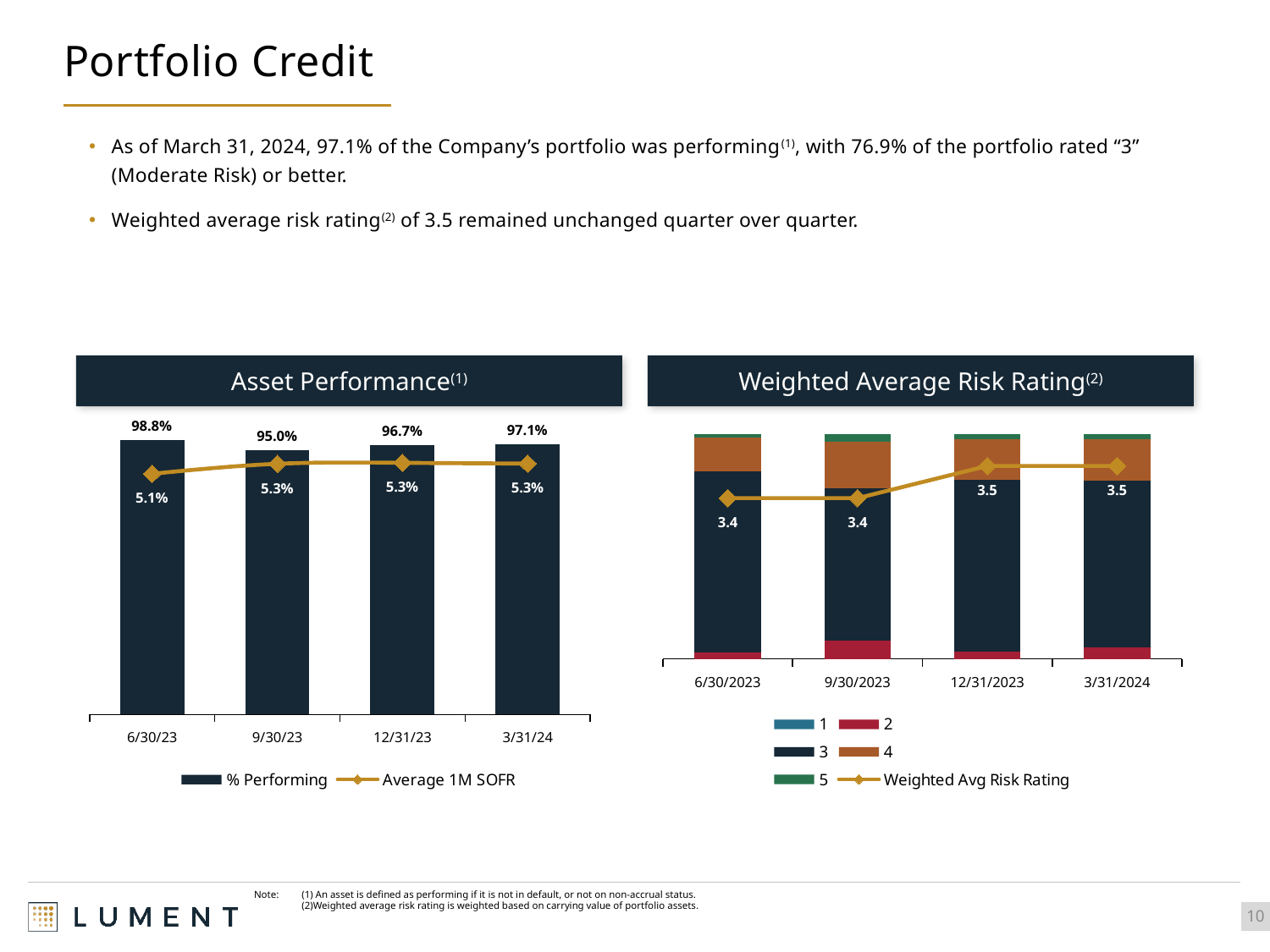
In the Asset Performance chart, which is larger: the % Performing for 12/31/23 or for 3/31/24? 3/31/24 In the Asset Performance chart, which quarter has the highest % Performing? 6/30/23 In the Asset Performance chart, how many series does the legend list? 2 In the Asset Performance chart, what is the Average 1M SOFR value for 6/30/23? 5.1% In the Asset Performance chart, what is the difference between the % Performing for 6/30/23 and 9/30/23? 3.8 percentage points In the Weighted Average Risk Rating chart, how many entries does the legend list? 6 In the Weighted Average Risk Rating chart, what is the Weighted Avg Risk Rating for 12/31/2023? 3.5 In the Asset Performance chart, which quarter has the lowest % Performing? 9/30/23 In the Asset Performance chart, what is the % Performing value for 9/30/23? 95.0% In the Asset Performance chart, how many quarters are shown on the x axis? 4 In the Weighted Average Risk Rating chart, what is the difference between the Weighted Avg Risk Rating for 3/31/2024 and 9/30/2023? 0.1 In the Weighted Average Risk Rating chart, does the Weighted Avg Risk Rating rise or fall from 6/30/2023 to 3/31/2024? rises